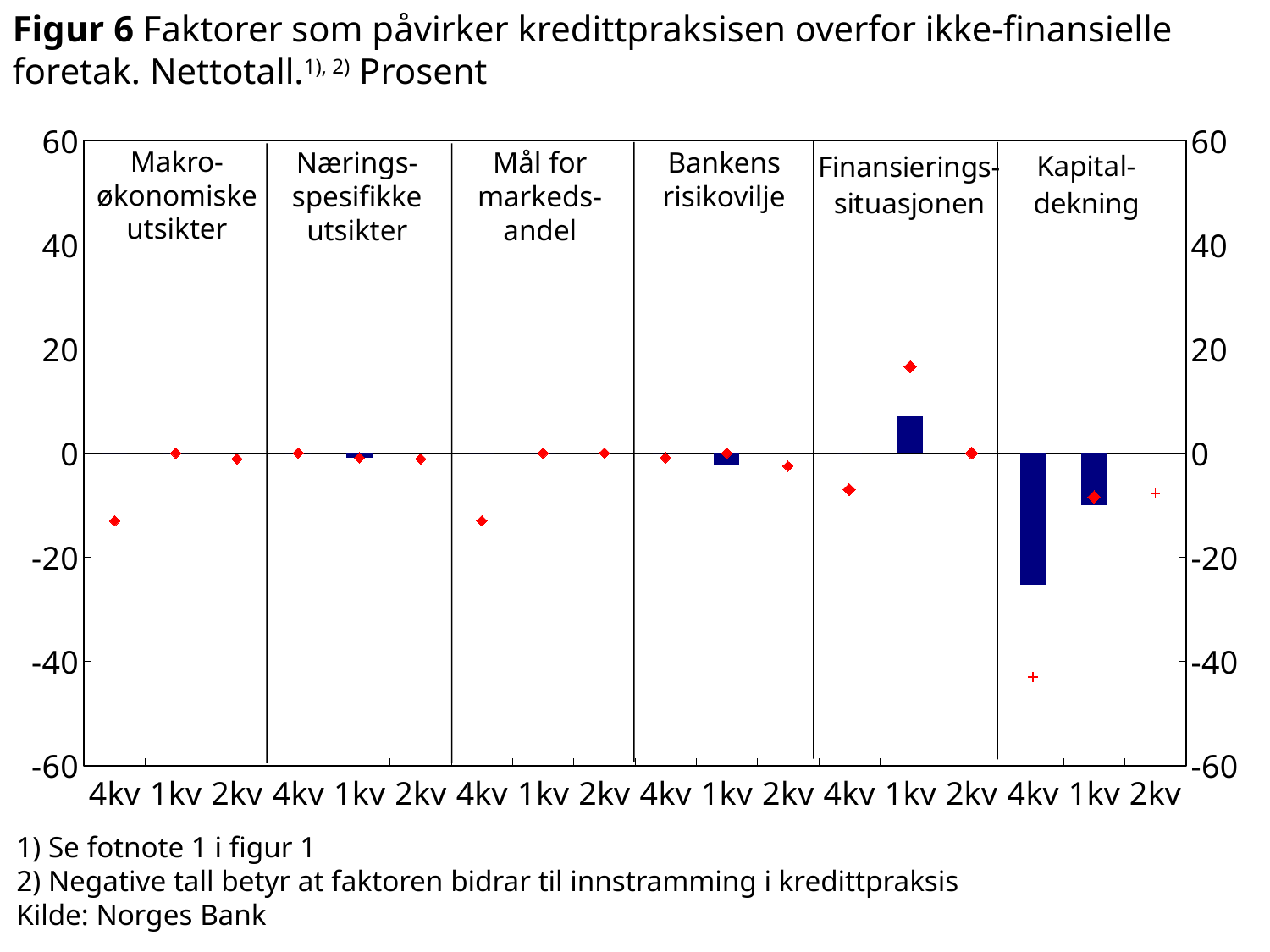
What kind of chart is shown on the slide? combination chart with bars and point markers What is the source given for the chart? Norges Bank Is the red diamond for 1kv under Finansieringssituasjonen greater or less than 20? less Is the red diamond for 1kv under Finansieringssituasjonen greater or less than 0? greater Is the red diamond for 4kv under Makroøkonomiske utsikter greater or less than 0? less How many factors (panels) are shown along the x axis of the chart? 6 Under Kapitaldekning, which bar is lower: 4kv or 1kv? 4kv How many quarters are shown within each factor panel of the chart? 3 Under which factor is the highest red diamond marker in the chart? Finansieringssituasjonen Under which factor is the lowest (most negative) bar in the chart? Kapitaldekning